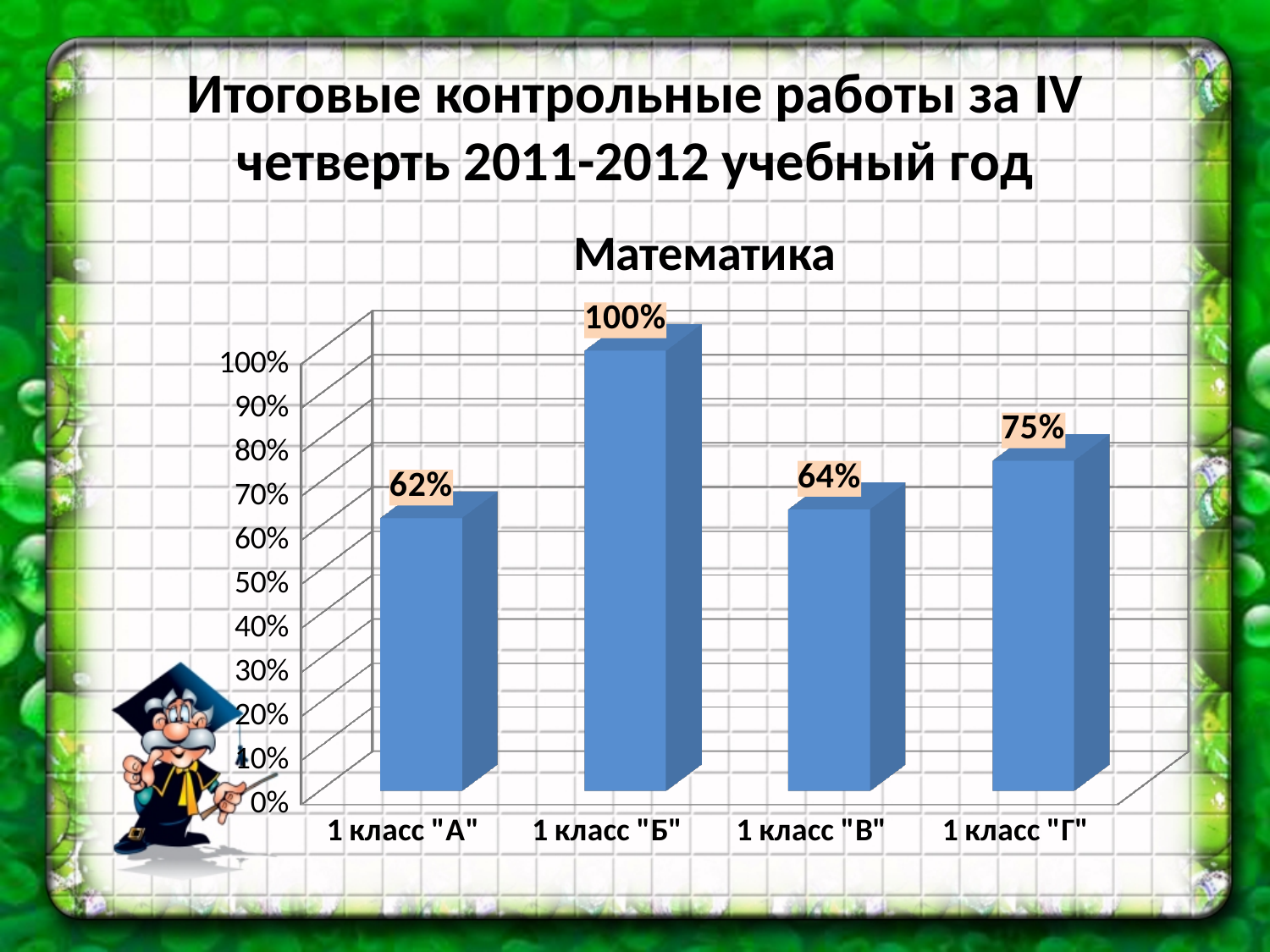
How many classes are shown on the chart? 4 What kind of chart is shown on the slide? bar chart What is the value for 1 класс "Б"? 100% Which class has the highest value? 1 класс "Б" What is the value for 1 класс "Г"? 75% What is the difference between the values for 1 класс "Б" and 1 класс "Г"? 25% What is the value for 1 класс "В"? 64% Which is larger, the value for 1 класс "Г" or the value for 1 класс "В"? 1 класс "Г" Which class has the lowest value? 1 класс "А" What is the difference between the values for 1 класс "В" and 1 класс "А"? 2% What is the value for 1 класс "А"? 62% What is the title of the chart? Математика